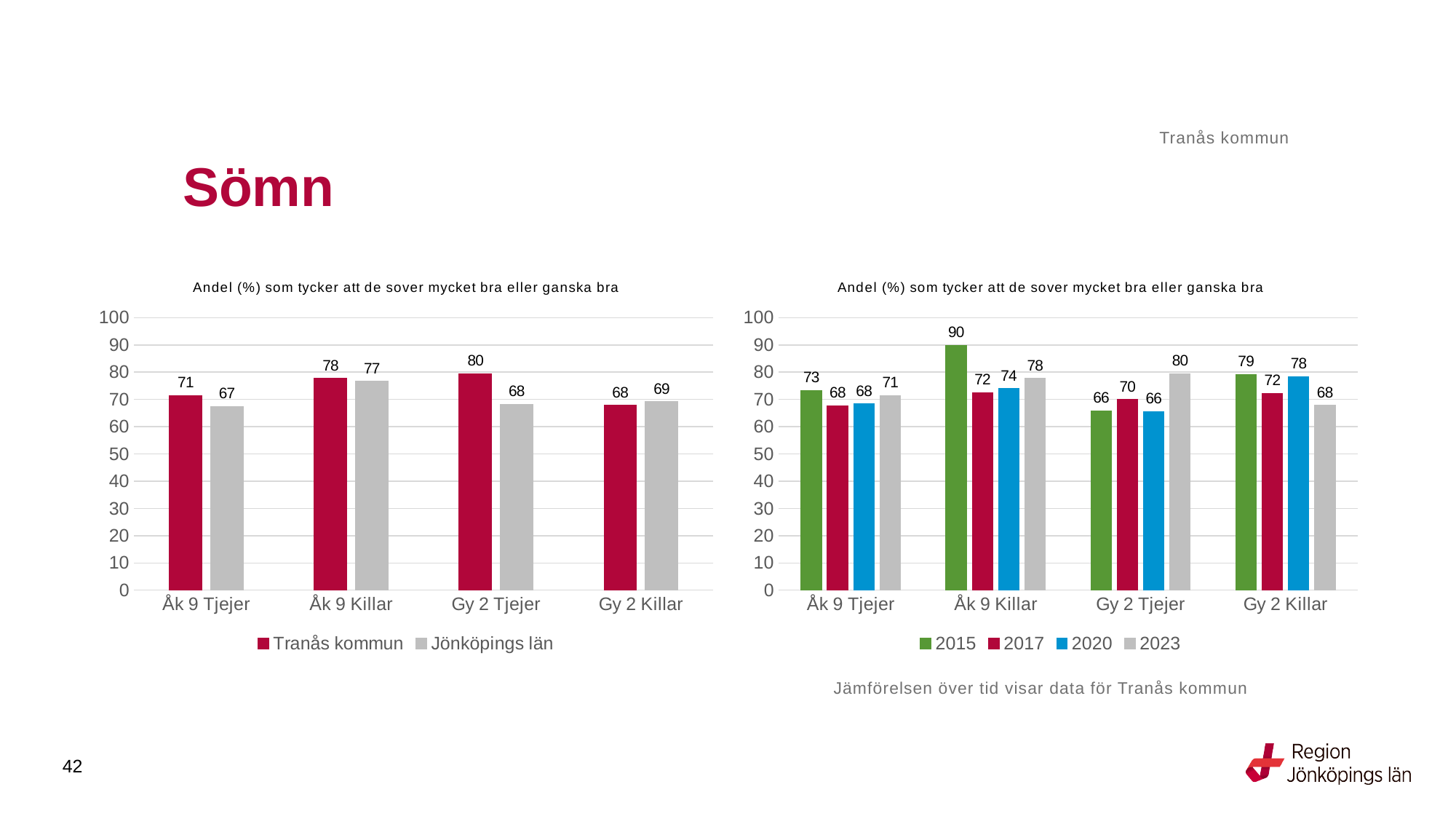
In the right chart, which category has the highest value for 2023? Gy 2 Tjejer In the right chart, is the value for 2015 for Gy 2 Tjejer larger or smaller than the value for 2017 for Gy 2 Tjejer? smaller In the left chart, what is the value for Jönköpings län for Åk 9 Tjejer? 67 What kind of chart is the right chart? Bar chart In the right chart, what is the value for 2015 for Åk 9 Killar? 90 In the left chart, which category has the lowest value for Tranås kommun? Gy 2 Killar In the left chart, what is the value for Tranås kommun for Gy 2 Tjejer? 80 In the right chart, how many series does the legend list? 4 In the left chart, what is the difference between Tranås kommun and Jönköpings län for Gy 2 Tjejer? 12 In the right chart, what is the value for 2020 for Gy 2 Killar? 78 In the right chart, what is the difference between the 2015 and 2023 values for Åk 9 Killar? 12 In the left chart, how many series does the legend list? 2